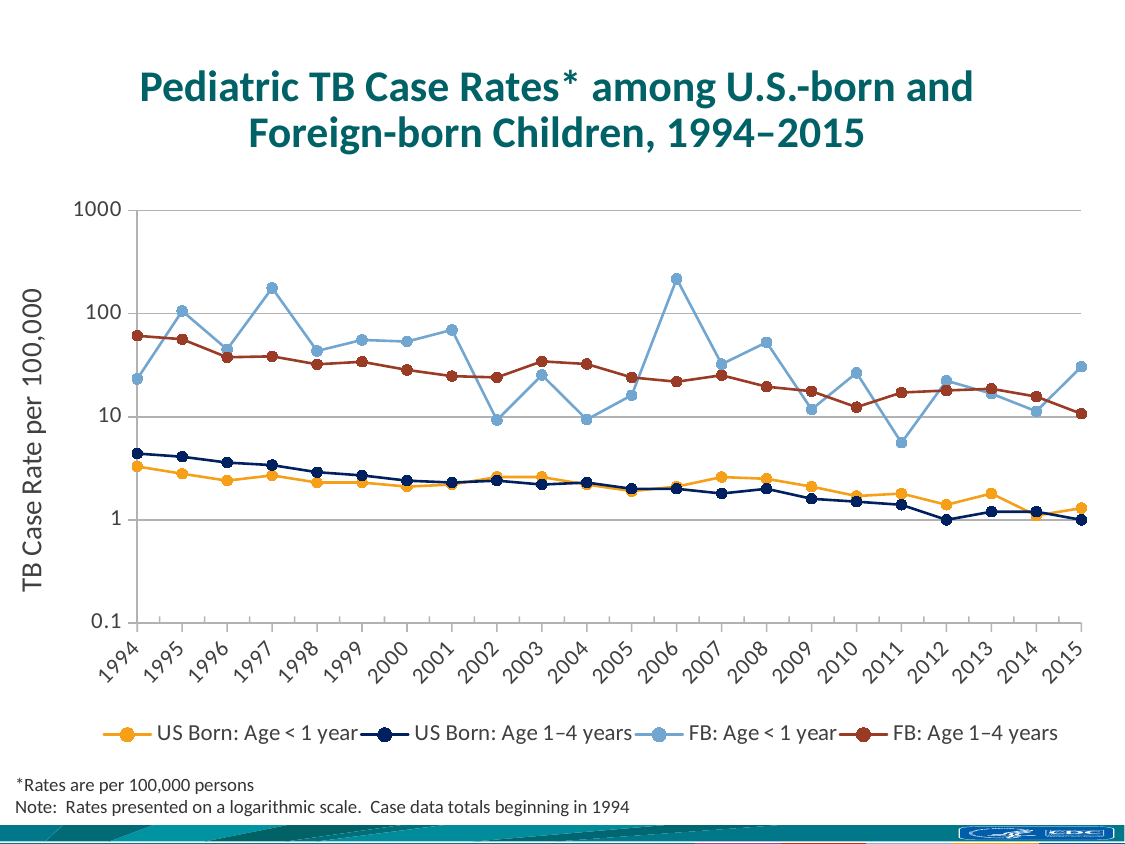
How many series does the legend list? 4 Does the US Born: Age 1–4 years series generally rise or fall from 1994 to 2015? fall What kind of chart is shown on the slide? line chart Is the value for FB: Age 1–4 years in 1994 greater or less than 100? less In which year does the FB: Age < 1 year series reach its lowest value? 2011 In 2002, which is larger: FB: Age < 1 year or FB: Age 1–4 years? FB: Age 1–4 years How many years are plotted along the x axis? 22 Is the value for FB: Age < 1 year in 2011 greater or less than 10? less In which year does the FB: Age < 1 year series reach its highest value? 2006 What is the label on the y axis of the chart? TB Case Rate per 100,000 Is the value for FB: Age < 1 year in 2006 greater or less than 100? greater